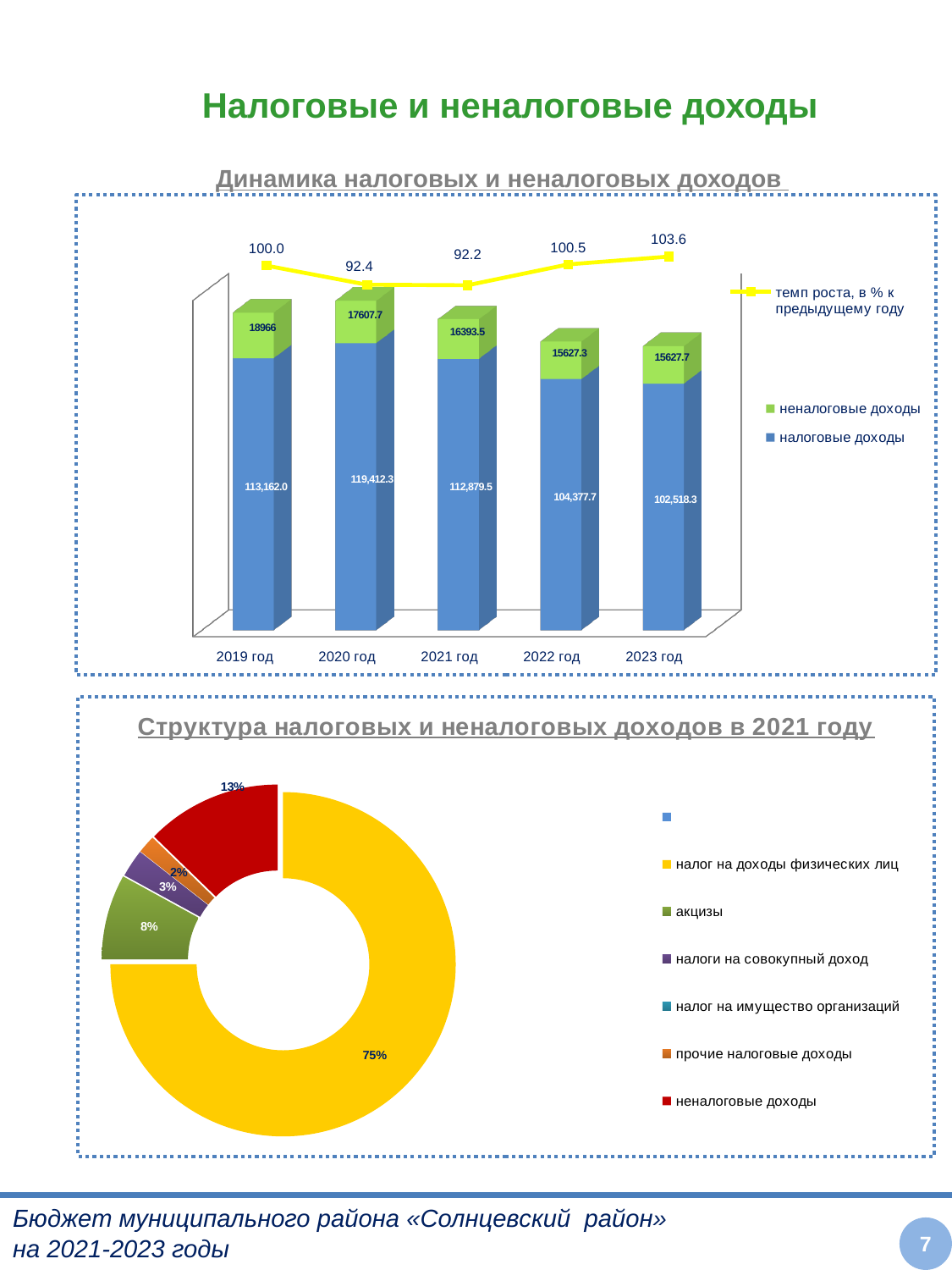
In the chart 'Динамика налоговых и неналоговых доходов', what is the difference between налоговые доходы in 2019 год and 2023 год? 10,643.7 In the chart 'Динамика налоговых и неналоговых доходов', is неналоговые доходы larger in 2019 год or in 2022 год? 2019 год In the chart 'Динамика налоговых и неналоговых доходов', what is the value of неналоговые доходы for 2021 год? 16393.5 In the chart 'Структура налоговых и неналоговых доходов в 2021 году', what share does неналоговые доходы have? 13% In the chart 'Динамика налоговых и неналоговых доходов', what is the value of налоговые доходы for 2020 год? 119,412.3 In the chart 'Динамика налоговых и неналоговых доходов', what is the темп роста value for 2023 год? 103.6 In the chart 'Динамика налоговых и неналоговых доходов', which year has the highest налоговые доходы? 2020 год In the chart 'Динамика налоговых и неналоговых доходов', how many entries does the legend list? 3 In the chart 'Динамика налоговых и неналоговых доходов', how many years are shown on the x axis? 5 In the chart 'Структура налоговых и неналоговых доходов в 2021 году', what share does налог на доходы физических лиц have? 75% What kind of chart is 'Структура налоговых и неналоговых доходов в 2021 году'? Doughnut (pie) chart In the chart 'Динамика налоговых и неналоговых доходов', which year has the lowest темп роста value? 2021 год